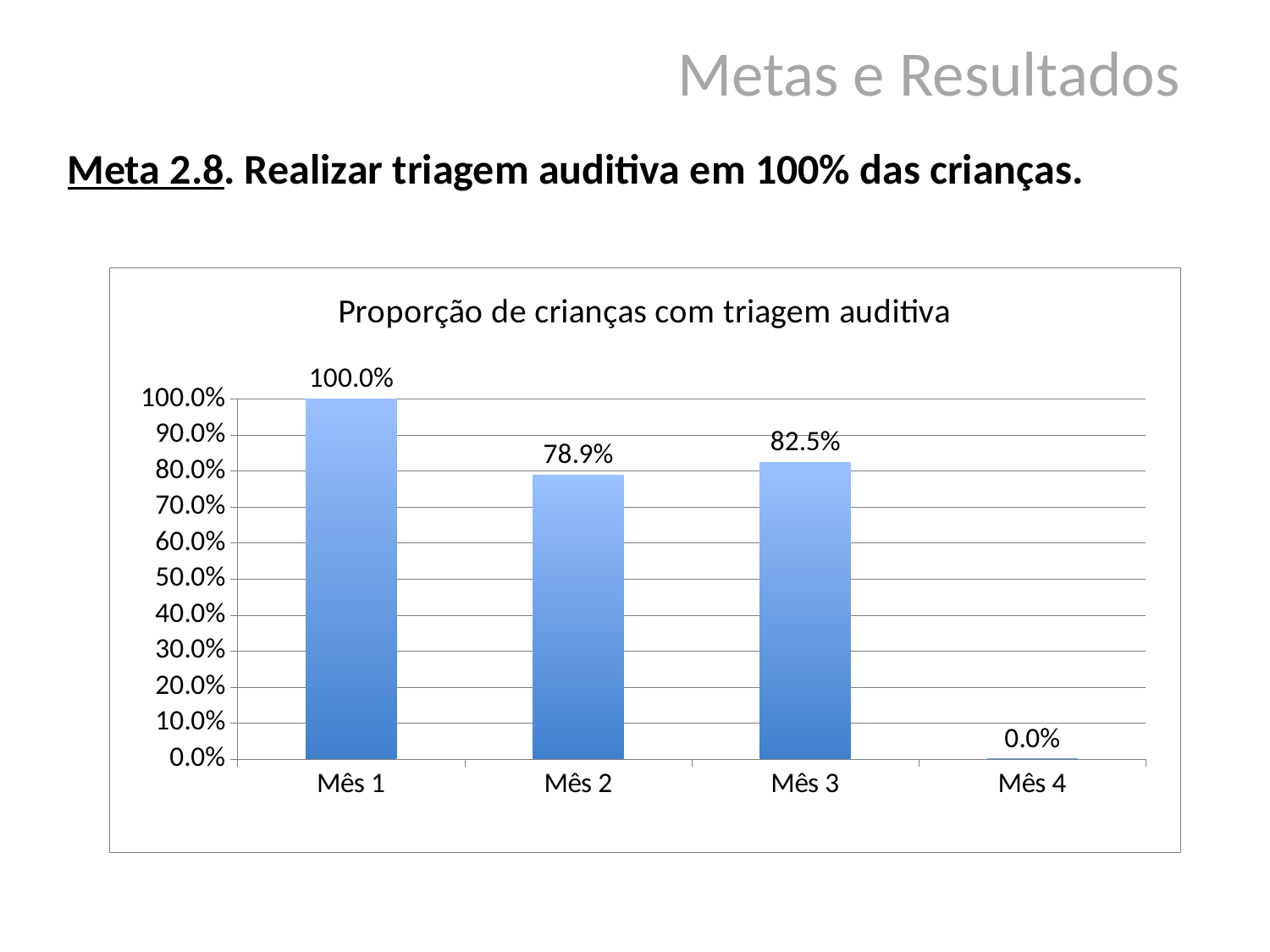
Which is larger, the value for Mês 2 or the value for Mês 3? Mês 3 What is the title of the chart? Proporção de crianças com triagem auditiva Which month has the lowest value? Mês 4 What kind of chart is this? Bar chart What is the difference between the values for Mês 3 and Mês 2? 3.6% What is the value for Mês 2? 78.9% How many months are shown on the x axis? 4 Which month has the highest value? Mês 1 What is the value for Mês 1? 100.0% What is the value for Mês 3? 82.5% What is the difference between the values for Mês 1 and Mês 2? 21.1% What is the value for Mês 4? 0.0%